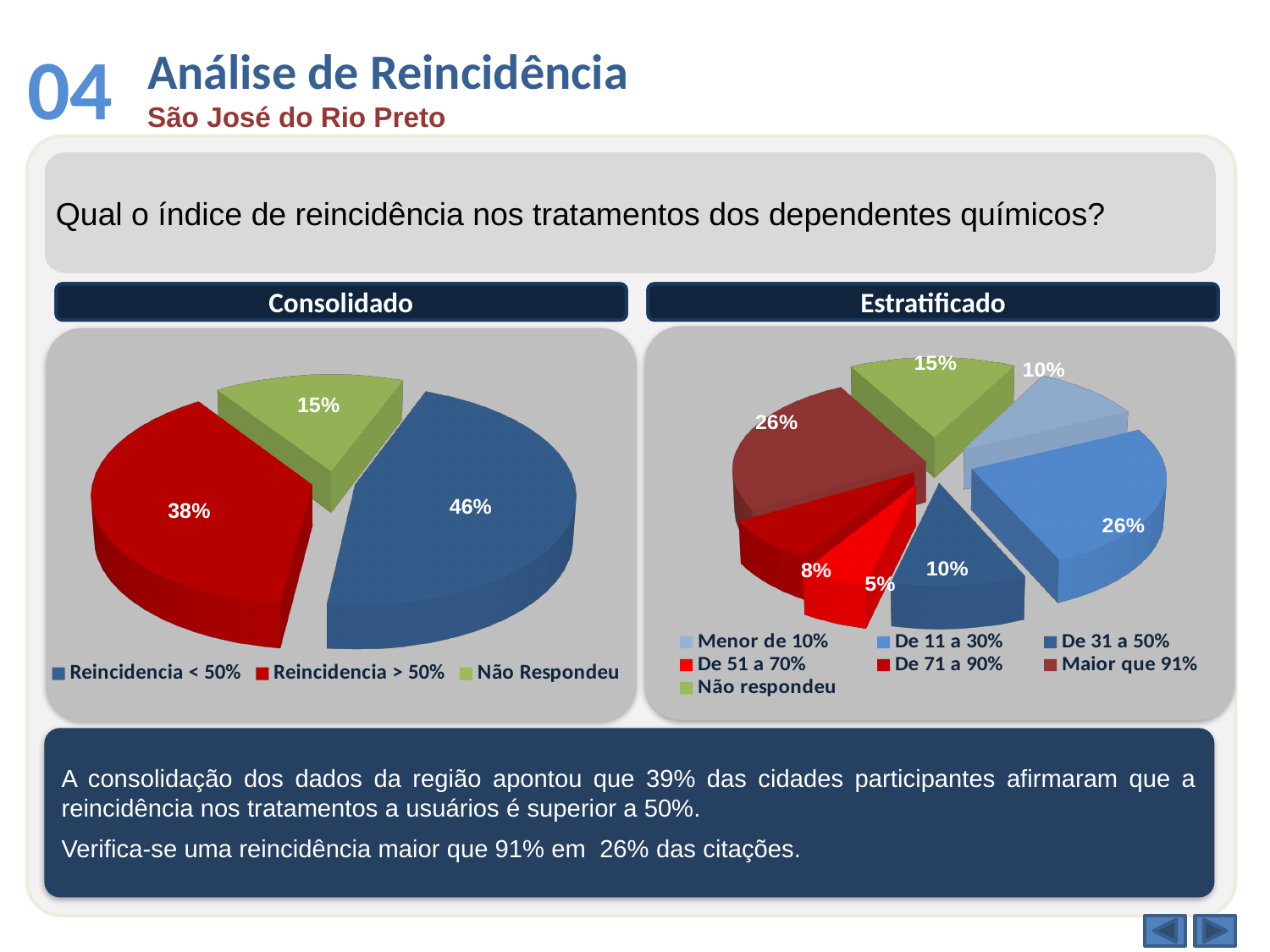
In the Estratificado chart, what percentage is shown for De 51 a 70%? 5% In the Estratificado chart, what percentage is shown for De 11 a 30%? 26% How many categories does the legend of the Estratificado chart list? 7 In the Consolidado chart, which category has the largest slice? Reincidencia < 50% In the Consolidado chart, what percentage is shown for Reincidencia < 50%? 46% In the Consolidado chart, which category has the smallest slice? Não Respondeu In the Estratificado chart, which category has the smallest slice? De 51 a 70% In the Estratificado chart, which is larger: Maior que 91% or De 71 a 90%? Maior que 91% In the Consolidado chart, what percentage is shown for Reincidencia > 50%? 38% In the Consolidado chart, what is the difference between Reincidencia < 50% and Reincidencia > 50%? 8% How many categories does the Consolidado chart show? 3 What type of chart is the Estratificado chart? Pie chart